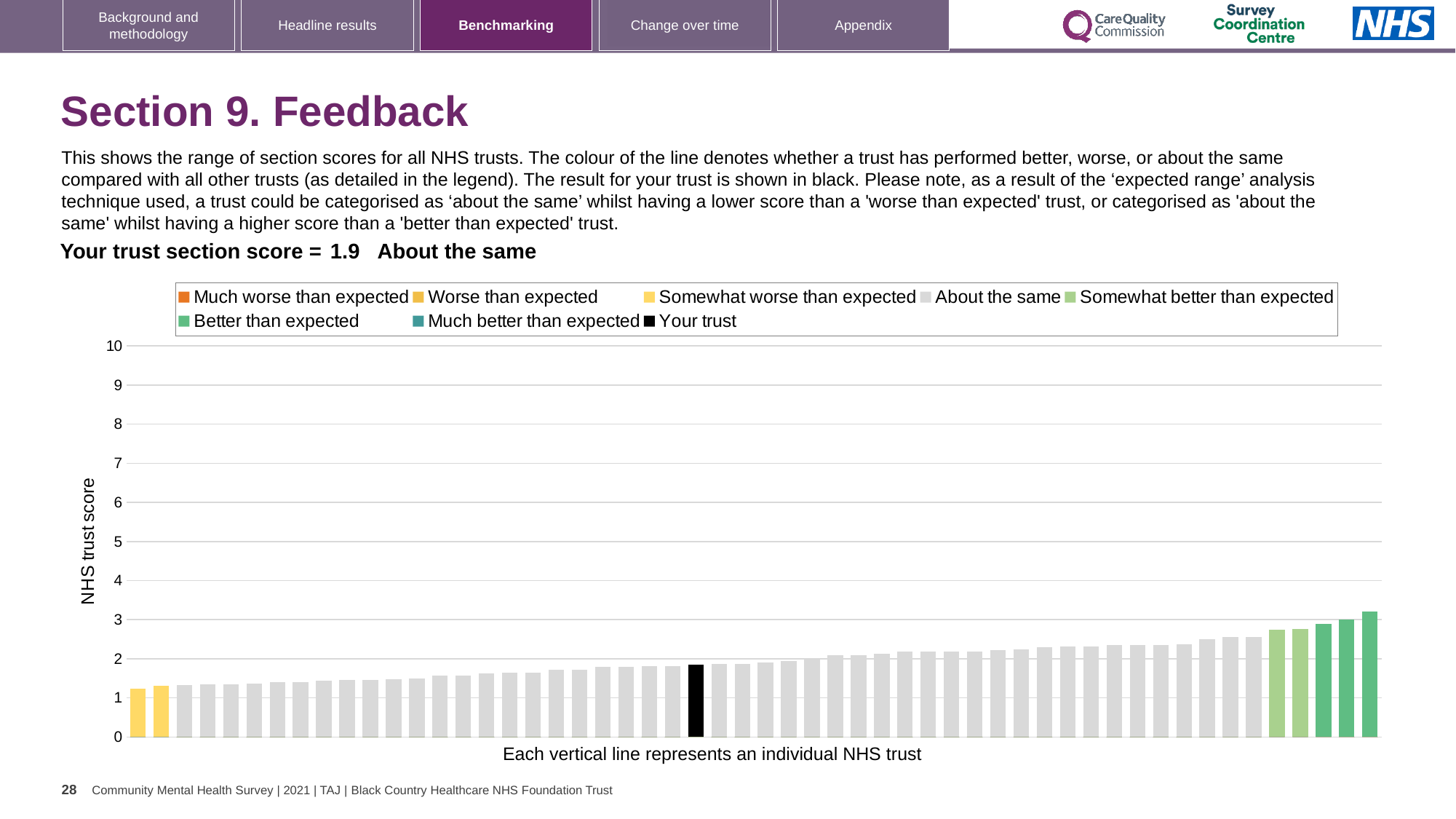
How many entries does the chart legend list? 8 Do the bar values rise or fall from left to right along the x axis? Rise What is the section score for your trust? 1.9 Which benchmarking category is your trust placed in for this section? About the same What colour is used for the bar representing your trust? Black Is the value for your trust (the black bar) greater or less than 2? less What is the label on the vertical axis of the chart? NHS trust score Which is larger, the leftmost bar or the rightmost bar? The rightmost bar Is the value of the lowest bar in the chart greater or less than 2? less Is the value of the highest bar in the chart greater or less than 3? greater What kind of chart is shown on the slide? Bar chart